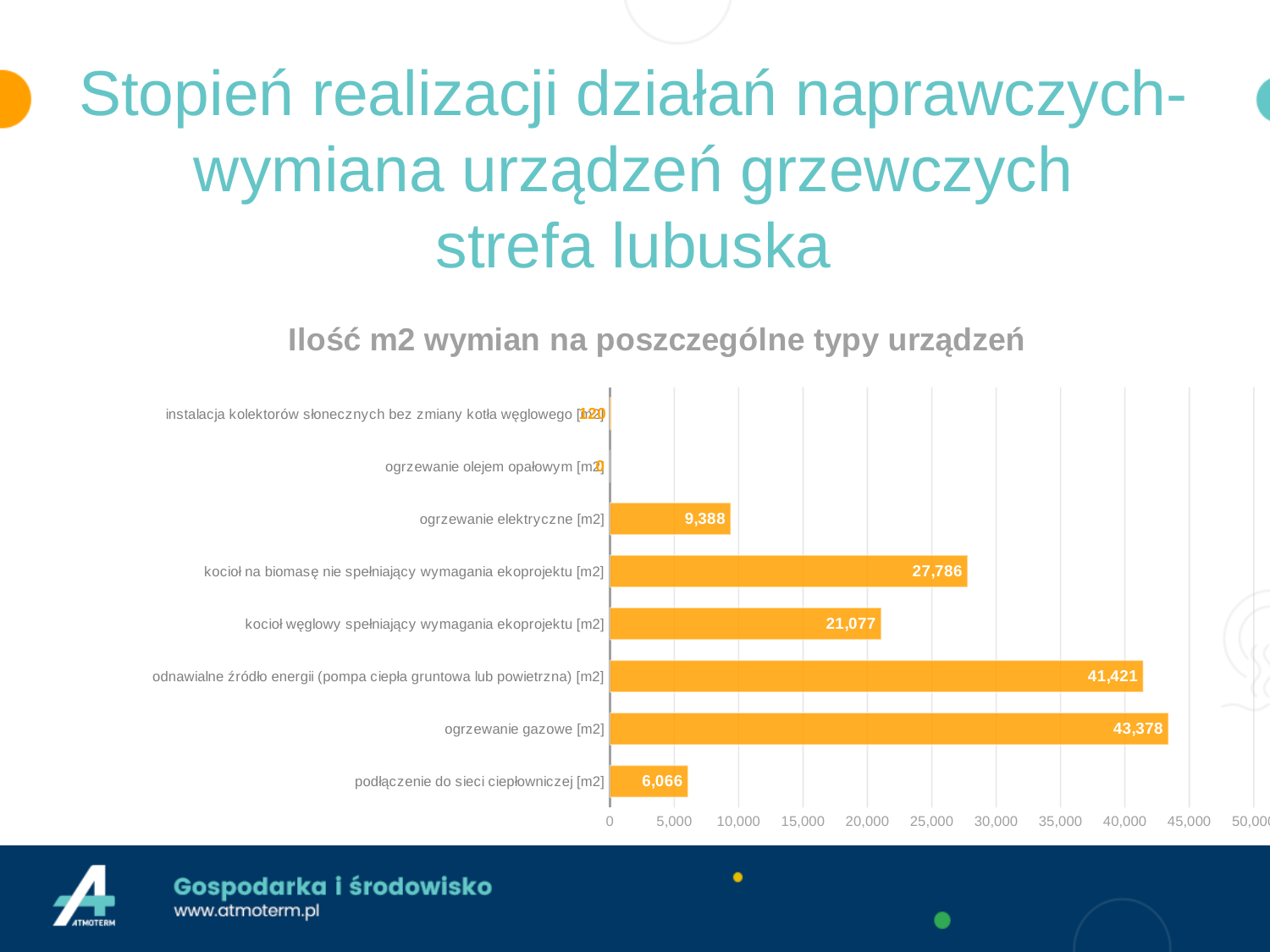
What is the value for odnawialne źródło energii (pompa ciepła gruntowa lub powietrzna) [m2]? 41,421 What is the difference between ogrzewanie gazowe [m2] and odnawialne źródło energii (pompa ciepła gruntowa lub powietrzna) [m2]? 1,957 Which category has the highest value? ogrzewanie gazowe [m2] Is the value for ogrzewanie elektryczne [m2] greater or less than 10,000? less What is the value for ogrzewanie gazowe [m2]? 43,378 Which is larger: ogrzewanie elektryczne [m2] or podłączenie do sieci ciepłowniczej [m2]? ogrzewanie elektryczne [m2] What is the title of the chart? Ilość m2 wymian na poszczególne typy urządzeń What is the difference between kocioł na biomasę nie spełniający wymagania ekoprojektu [m2] and kocioł węglowy spełniający wymagania ekoprojektu [m2]? 6,709 How many categories are shown in the chart? 8 What is the value for kocioł węglowy spełniający wymagania ekoprojektu [m2]? 21,077 What type of chart is shown on the slide? bar chart What is the value for podłączenie do sieci ciepłowniczej [m2]? 6,066